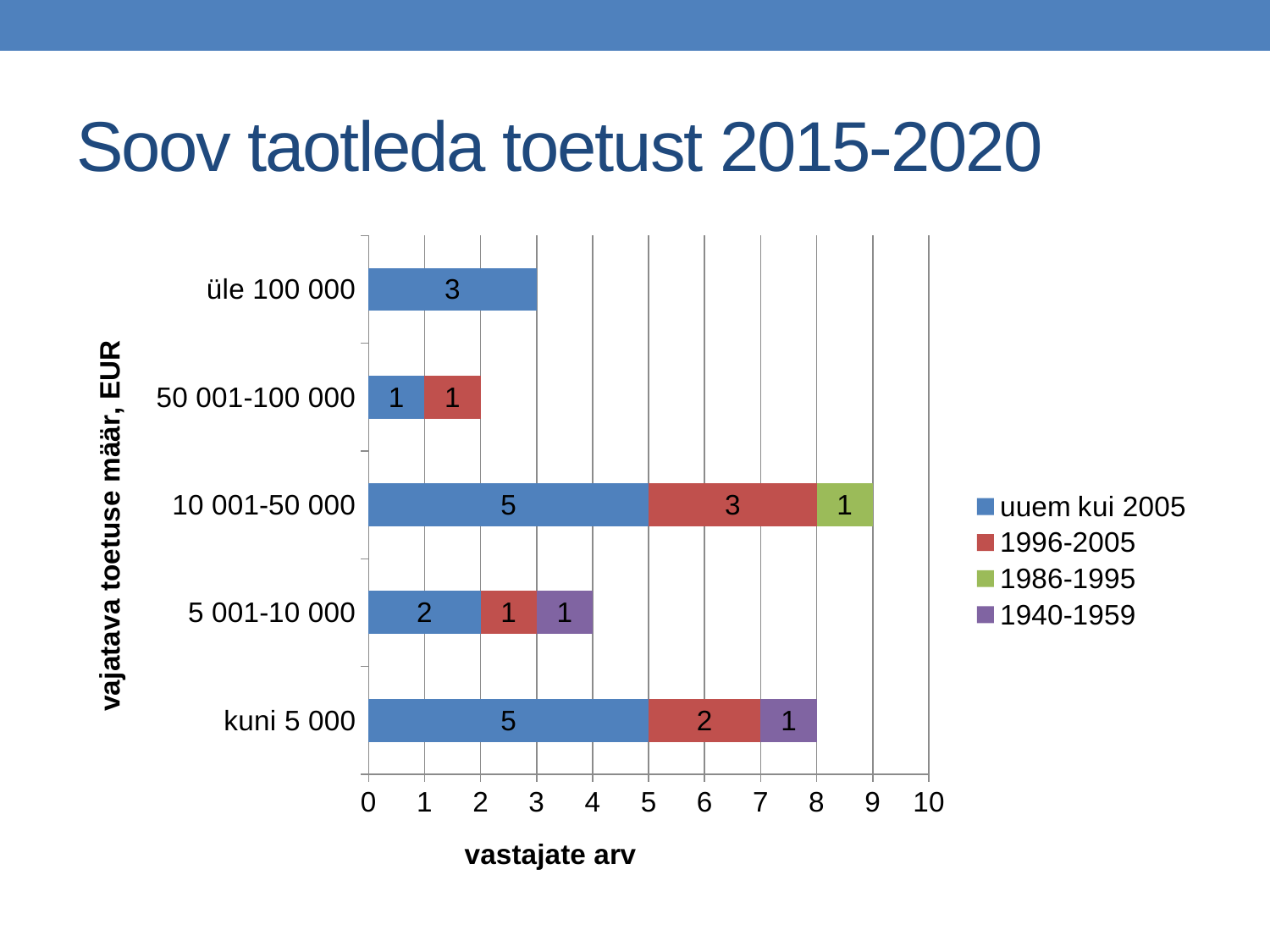
What is the label of the horizontal axis? vastajate arv Which category has the highest total number of respondents? 10 001-50 000 Which category has the lowest total number of respondents? 50 001-100 000 How many series does the legend list? 4 What is the total of the stacked bar for 'kuni 5 000'? 8 How many categories are shown on the vertical axis? 5 What type of chart is shown on the slide? stacked bar chart What is the difference between the 'uuem kui 2005' value for 'kuni 5 000' and for '5 001-10 000'? 3 What is the total of the stacked bar for '10 001-50 000'? 9 What is the value for '1986-1995' in the '10 001-50 000' category? 1 What is the value for '1996-2005' in the 'kuni 5 000' category? 2 What is the value for 'uuem kui 2005' in the '10 001-50 000' category? 5